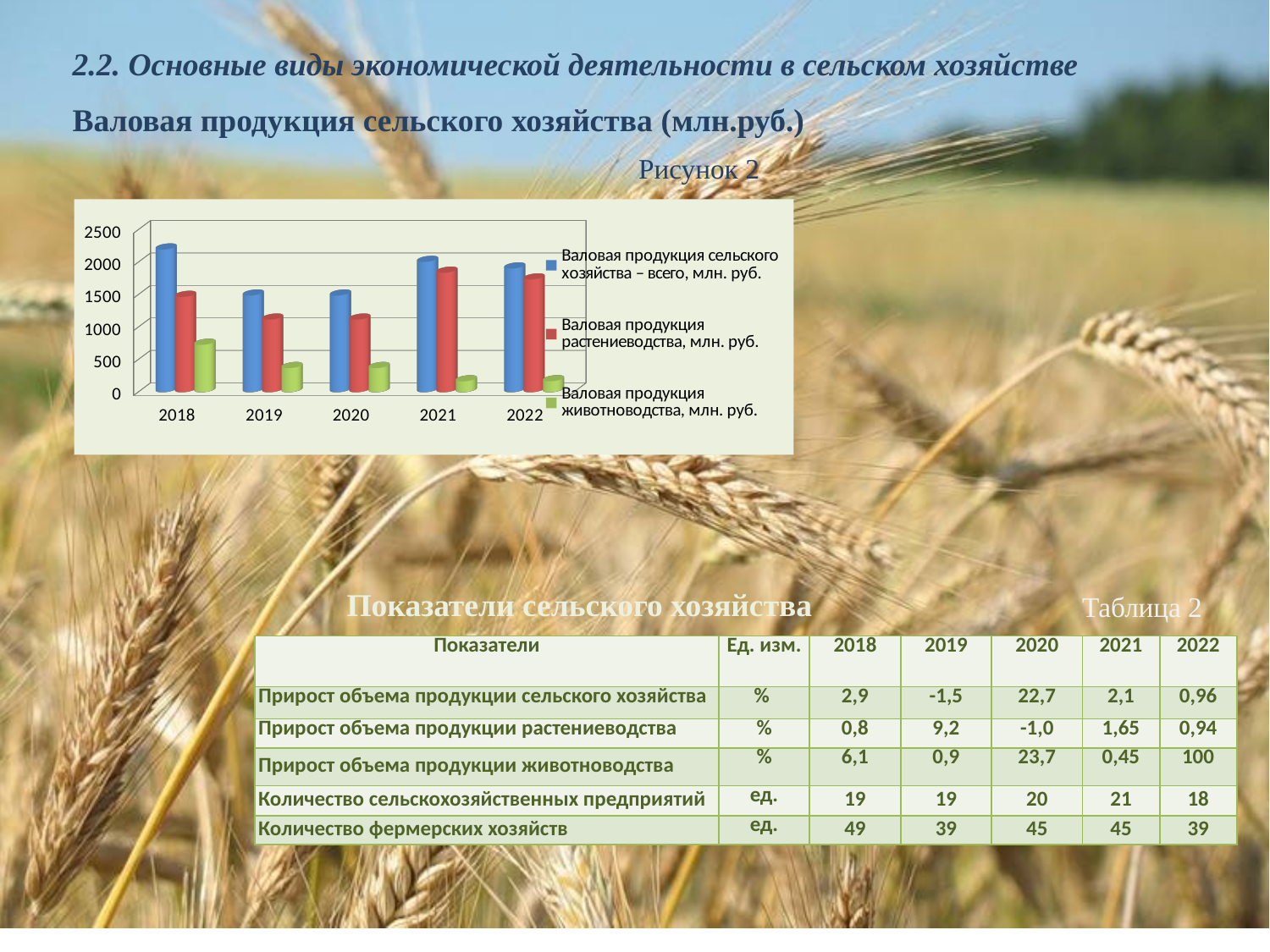
Is the value for Валовая продукция животноводства in 2019 greater or less than 500? less Is the value for Валовая продукция сельского хозяйства – всего in 2018 greater or less than 2000? greater How many series does the chart legend list? 3 Is the value for Валовая продукция сельского хозяйства – всего in 2019 greater or less than 2000? less Which year has the highest value for Валовая продукция сельского хозяйства – всего? 2018 Which is larger: Валовая продукция растениеводства in 2018 or in 2021? 2021 What kind of chart is shown in Рисунок 2? bar chart Do the values for Валовая продукция животноводства generally rise or fall from 2018 to 2022? fall How many years are shown on the x axis of the chart? 5 Which series in the chart is shown in green? Валовая продукция животноводства, млн. руб. Which year has the highest value for Валовая продукция животноводства? 2018